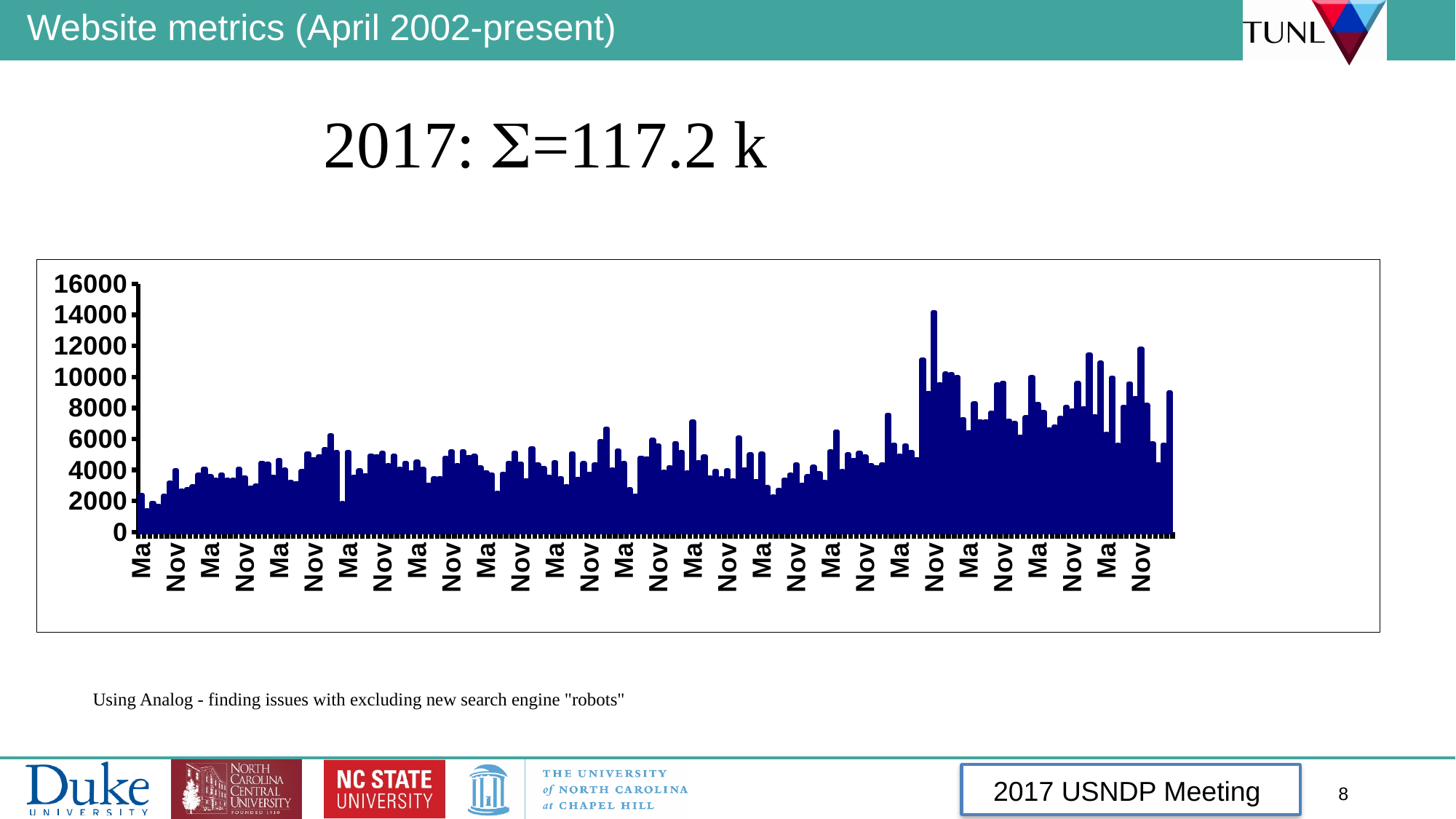
Is the value of the first bar on the left of the chart greater or less than 4000? less Which is larger: the tallest bar in the left half of the chart or the tallest bar in the right half of the chart? the right half What is the highest value labelled on the vertical axis of the chart? 16000 What is the interval between consecutive tick labels on the vertical axis? 2000 Is the tallest bar in the left half of the chart greater or less than 8000? less Is the tallest bar in the chart greater or less than 12000? greater What kind of chart is shown on the slide? bar chart What total is stated for 2017 in the text above the chart? Σ=117.2 k Overall, do the bar values tend to rise or fall from the left of the chart to the right? rise